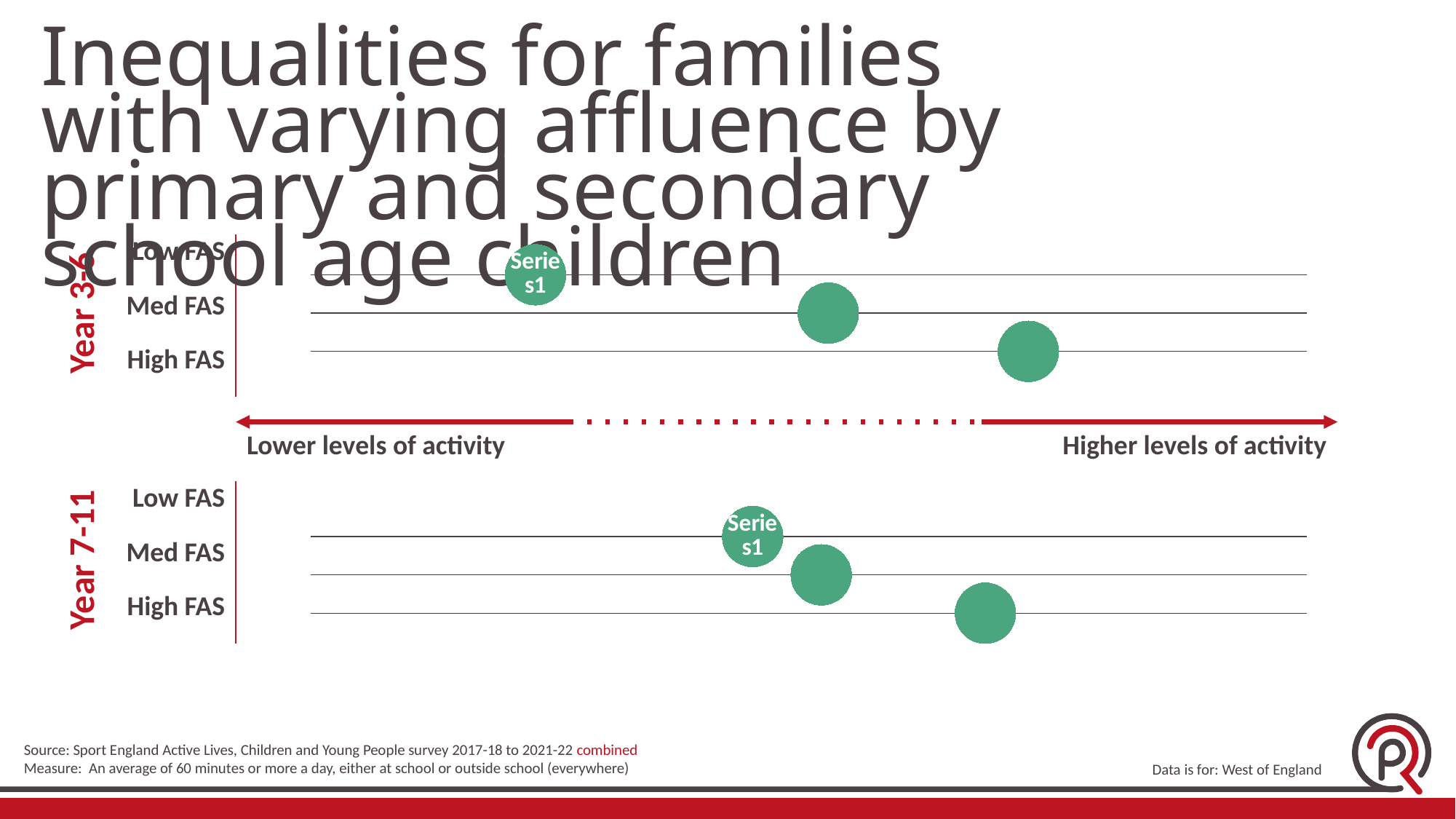
How many FAS categories are plotted in the Year 7-11 chart? 3 In the Year 3-6 chart, which has the higher level of activity, Med FAS or High FAS? High FAS What label is shown at the right end of the horizontal axis between the two charts? Higher levels of activity In the Year 3-6 chart, which FAS category has the highest level of activity? High FAS In the Year 7-11 chart, which FAS category has the lowest level of activity? Low FAS In the Year 3-6 chart, does the level of activity rise or fall as family affluence goes from Low FAS to High FAS? rise In the Year 7-11 chart, does the level of activity rise or fall as family affluence goes from Low FAS to High FAS? rise How many FAS categories are plotted in the Year 3-6 chart? 3 What colour are the data markers in both charts? Green In the Year 3-6 chart, which FAS category has the lowest level of activity? Low FAS In the Year 7-11 chart, which has the lower level of activity, Low FAS or Med FAS? Low FAS In the Year 7-11 chart, which FAS category has the highest level of activity? High FAS